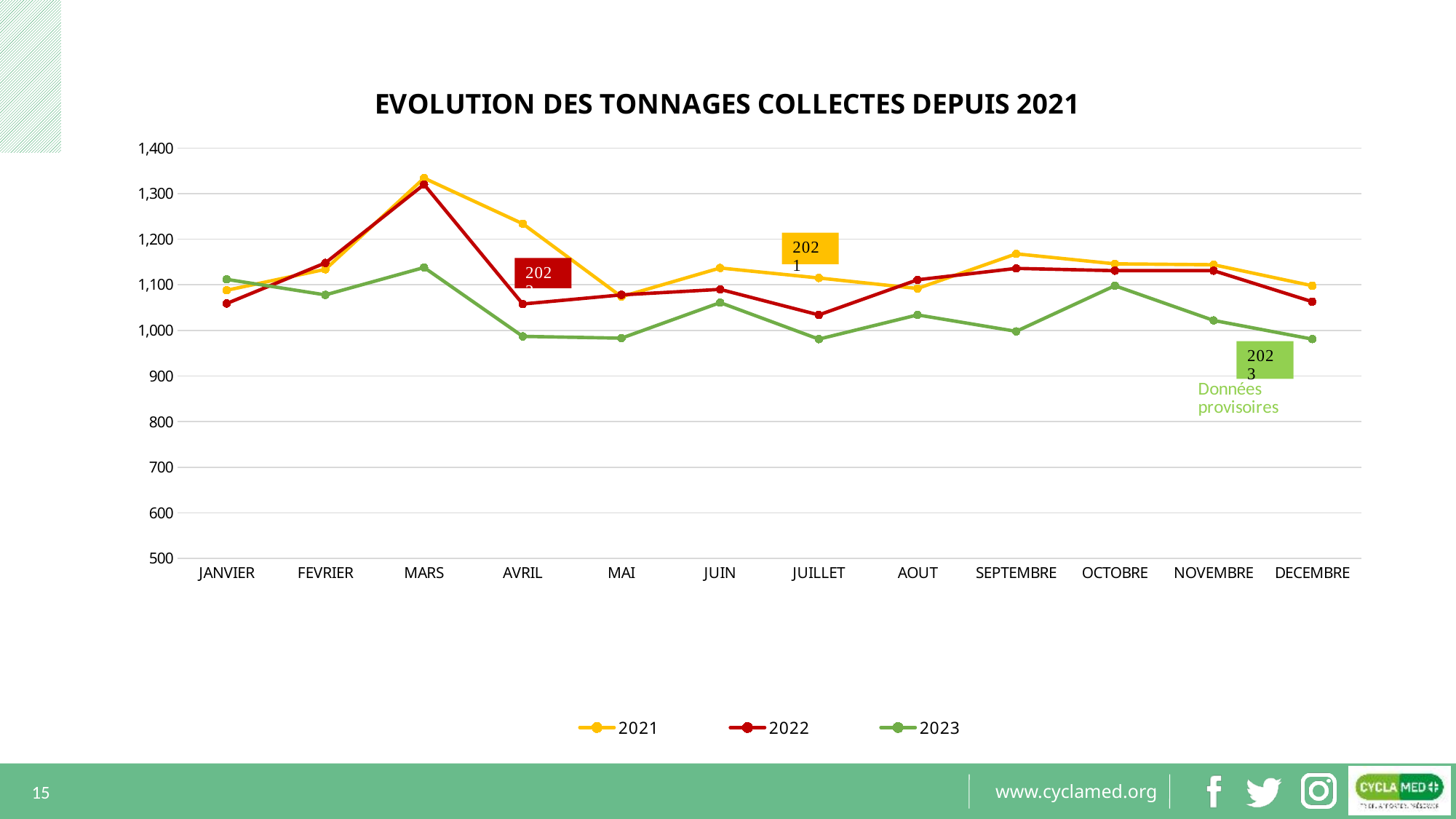
What kind of chart is shown on the slide? line chart In JANVIER, which series has the larger value, 2022 or 2023? 2023 How many series does the legend list? 3 Is the value for 2021 in MARS greater or less than 1,300? greater Is the value for 2022 in JUILLET greater or less than 1,100? less Is the value for 2023 in AVRIL greater or less than 1,000? less In which month does the 2021 series reach its highest value? MARS Does the 2021 series rise or fall from MARS to MAI? fall In JUIN, which series has the larger value, 2021 or 2023? 2021 In which month does the 2022 series reach its highest value? MARS In which month does the 2022 series reach its lowest value? JUILLET How many months are shown along the x axis? 12